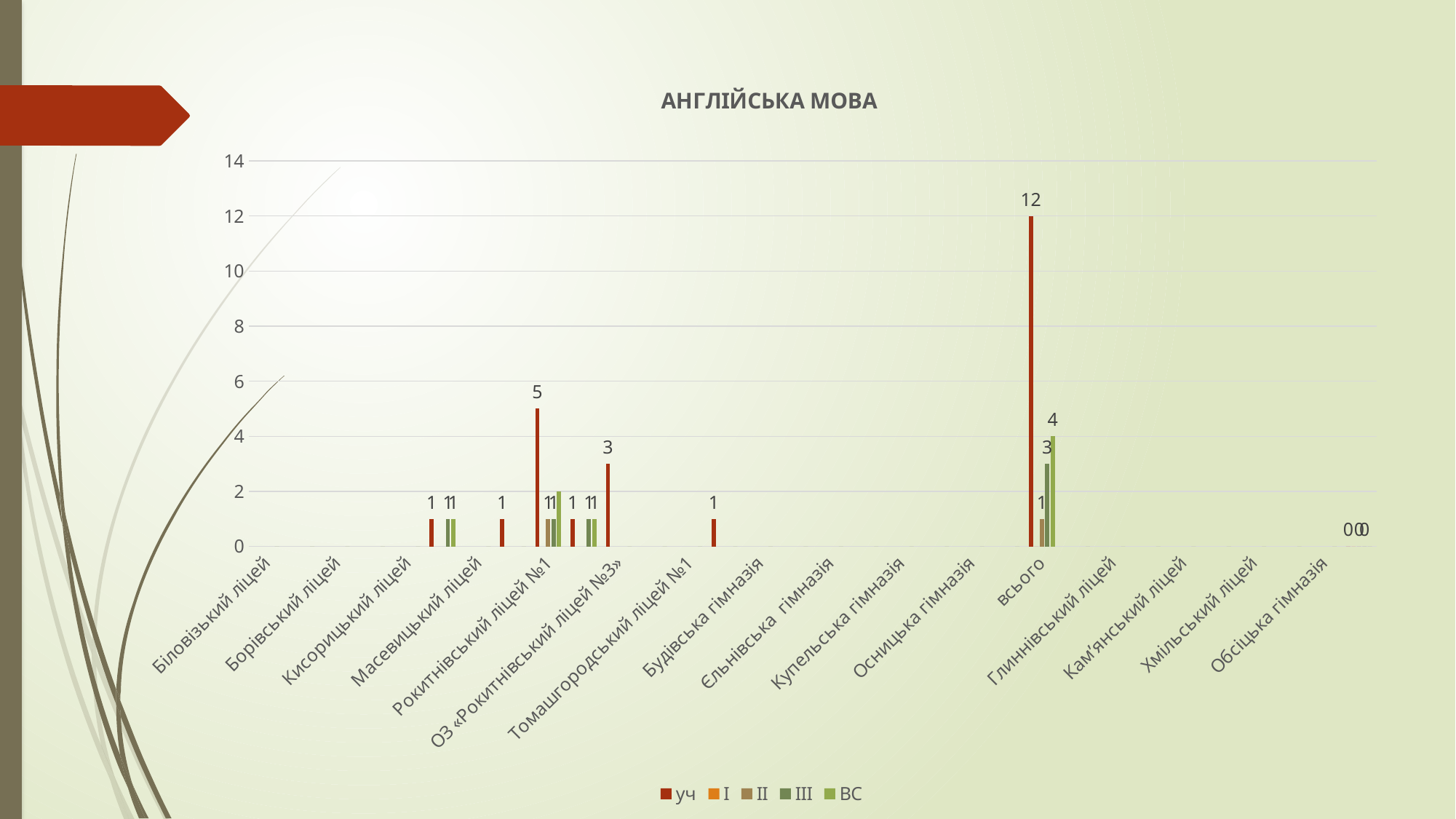
What kind of chart is shown on the slide? bar chart What are the series names listed in the legend? уч, I, II, III, ВС What is the value of the III series for всього? 3 Which has the larger уч value: Рокитнівський ліцей №1 or ОЗ «Рокитнівський ліцей №3»? Рокитнівський ліцей №1 What is the value of the ВС series for всього? 4 What is the title of the chart? АНГЛІЙСЬКА МОВА What is the value of the уч series for ОЗ «Рокитнівський ліцей №3»? 3 What is the value of the уч series for всього? 12 Which category has the highest value in the уч series? всього How many series does the legend list? 5 What is the difference between the уч value for всього and the уч value for Рокитнівський ліцей №1? 7 What is the value of the уч series for Рокитнівський ліцей №1? 5